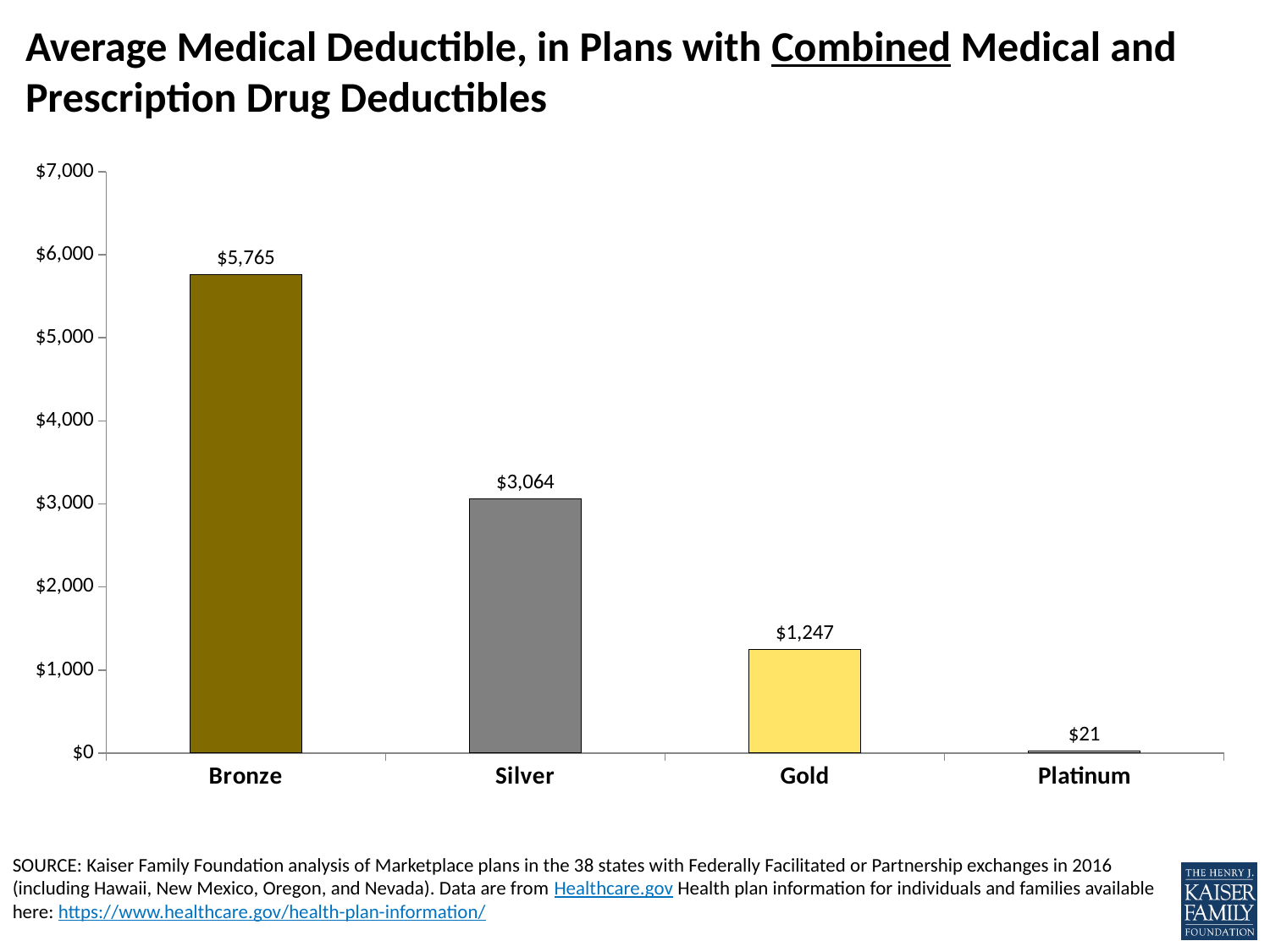
What is the average medical deductible for Platinum plans? $21 What is the average medical deductible for Bronze plans? $5,765 How many plan types are shown on the chart? 4 What is the difference between the Bronze and Silver average medical deductibles? $2,701 What kind of chart is shown on the slide? Bar chart What is the average medical deductible for Silver plans? $3,064 Which plan type has the highest average medical deductible? Bronze Which plan type has the lowest average medical deductible? Platinum What is the difference between the Gold and Platinum average medical deductibles? $1,226 What is the average medical deductible for Gold plans? $1,247 Do the values rise or fall moving from Bronze to Platinum along the x axis? Fall Which has a larger average medical deductible, Silver or Gold? Silver